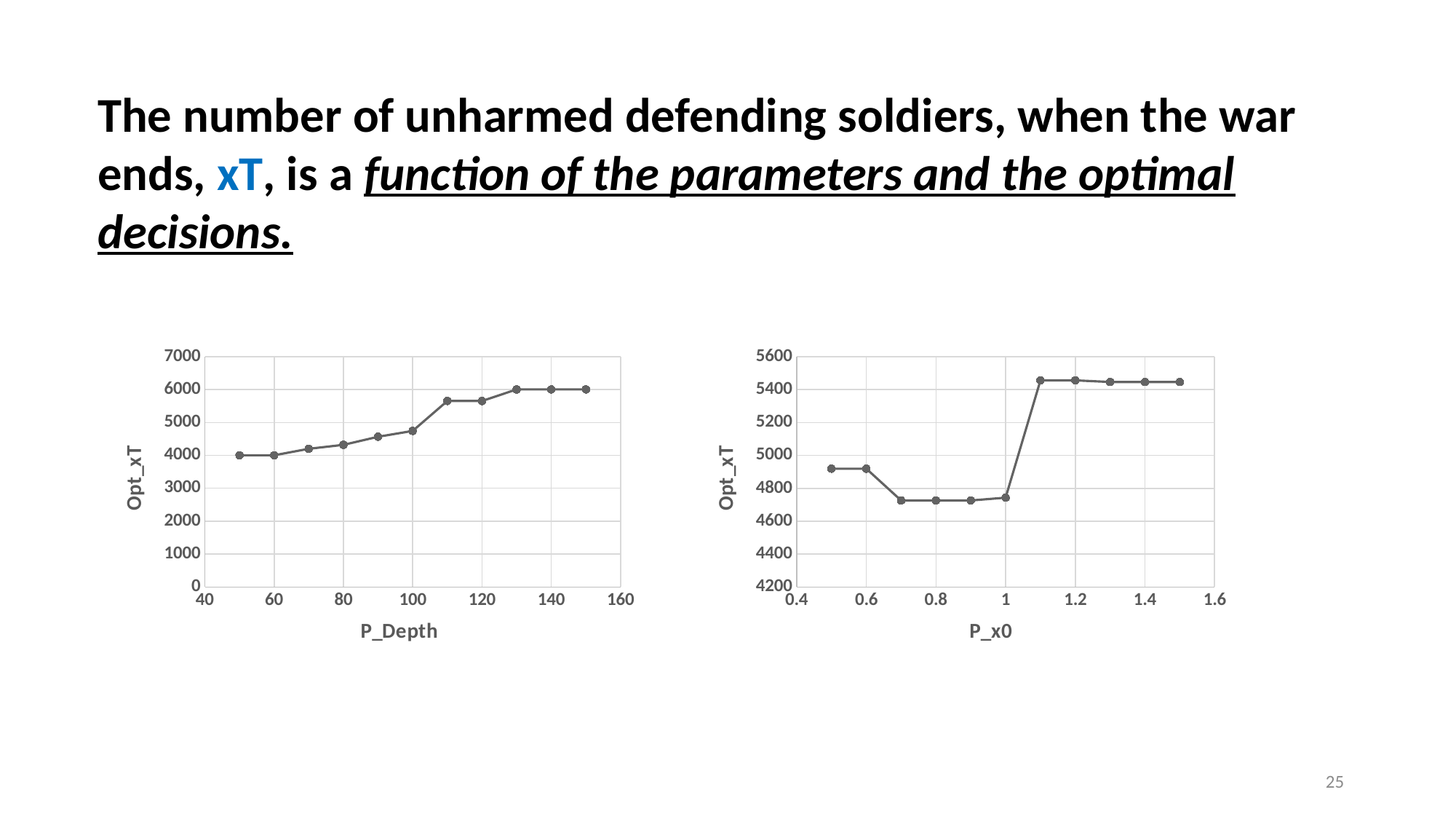
What kind of chart is the left chart (P_Depth vs Opt_xT)? line chart In the left chart (P_Depth), how many data points are plotted? 11 What kind of chart is the right chart (P_x0 vs Opt_xT)? line chart In the right chart (P_x0), is the value of Opt_xT at P_x0 = 0.8 greater or less than 5000? less In the right chart (P_x0), is the value of Opt_xT at P_x0 = 1.2 greater or less than 5200? greater What is the x-axis label of the right chart? P_x0 In the left chart (P_Depth), which has the larger Opt_xT value: P_Depth = 100 or P_Depth = 110? P_Depth = 110 In the left chart (P_Depth), is the value of Opt_xT at P_Depth = 50 greater or less than 5000? less In the right chart (P_x0), which has the larger Opt_xT value: P_x0 = 0.5 or P_x0 = 0.7? P_x0 = 0.5 In the left chart (P_Depth), does Opt_xT generally rise or fall as P_Depth increases? rise In the right chart (P_x0), how many data points are plotted? 11